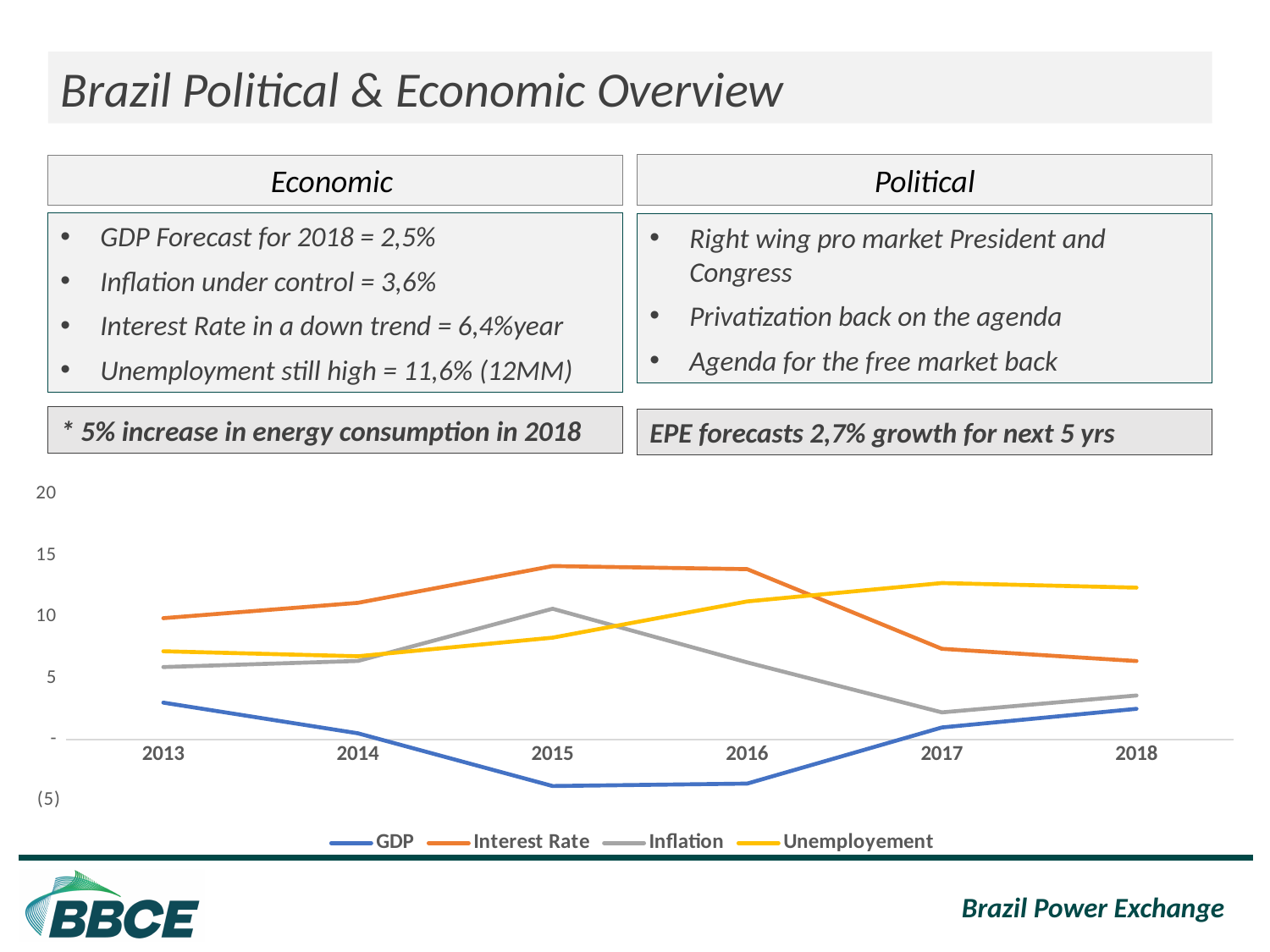
Which series has the highest value in 2015? Interest Rate In 2018, which is larger: Unemployement or Interest Rate? Unemployement Is the value for GDP in 2016 greater or less than 5? less Is the value for Interest Rate in 2015 greater or less than 10? greater How many series does the chart legend list? 4 Which series has the lowest value in 2016? GDP In which year does the Inflation series reach its highest value? 2015 How many years are shown on the x axis of the chart? 6 Does the Unemployement line rise or fall from 2014 to 2017? rise What kind of chart is shown on the slide? line chart Does the Interest Rate line rise or fall from 2016 to 2018? fall Is the value for Unemployement in 2017 greater or less than 10? greater